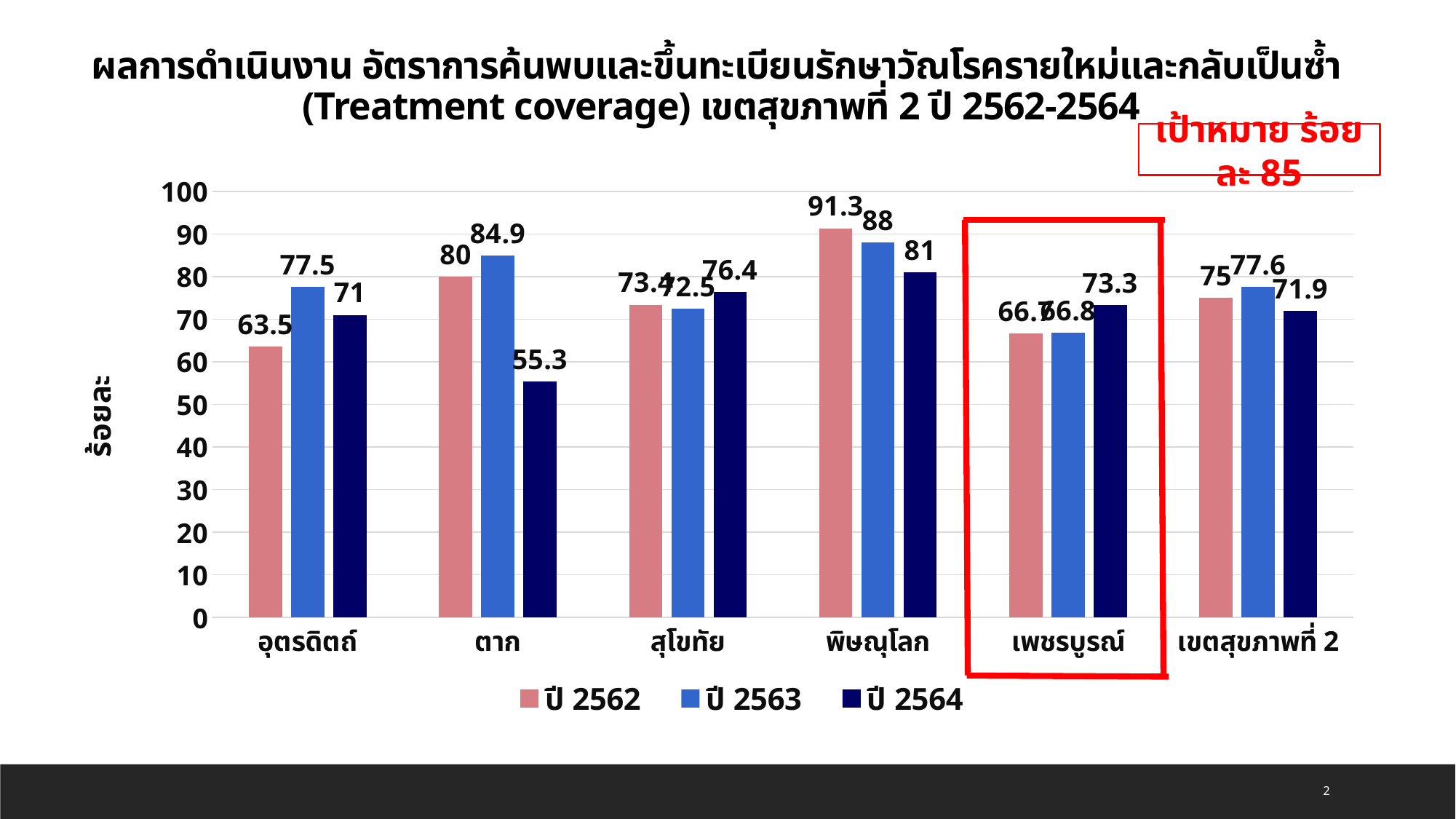
What is the value for พิษณุโลก in ปี 2564? 81 How many categories are shown on the x axis? 6 Do the values for พิษณุโลก rise or fall from ปี 2562 to ปี 2564? fall What is the value for ตาก in ปี 2563? 84.9 Is the value for เพชรบูรณ์ in ปี 2562 greater or less than 70? less Which category has the lowest value in ปี 2564? ตาก What kind of chart is shown on the slide? bar chart For อุตรดิตถ์, which is larger: the ปี 2563 value or the ปี 2564 value? ปี 2563 Which category has the highest value in ปี 2562? พิษณุโลก What is the difference between the ปี 2563 and ปี 2564 values for ตาก? 29.6 What is the value for เขตสุขภาพที่ 2 in ปี 2562? 75 How many series does the legend list? 3